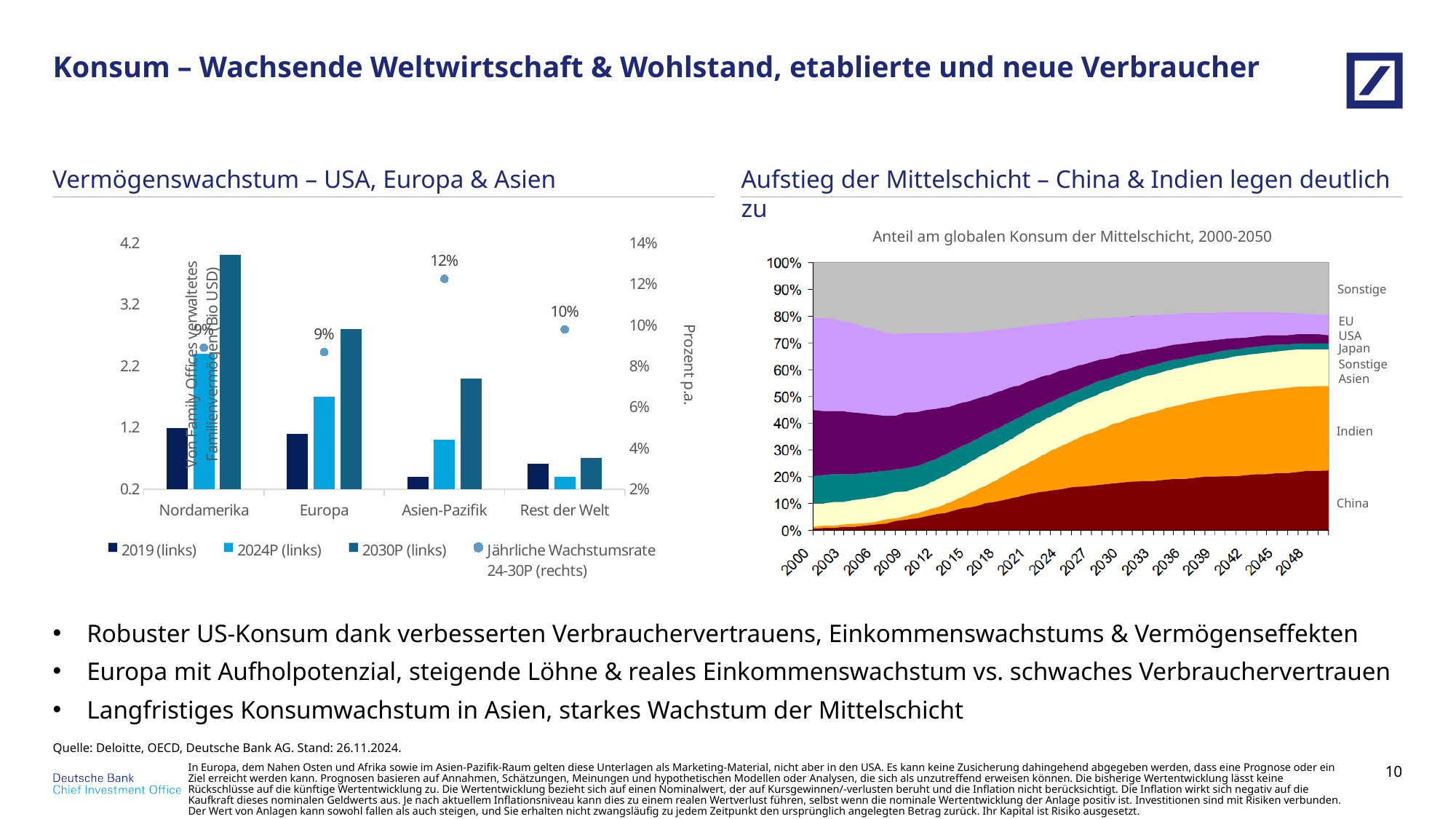
In the right chart (Anteil am globalen Konsum der Mittelschicht), does China's share rise or fall from 2000 to 2050? Rises In the left chart (Vermögenswachstum), is the 2019 value for Asien-Pazifik greater or less than 1.2? less In the left chart (Vermögenswachstum), which has the larger 2030P value: Europa or Asien-Pazifik? Europa In the left chart (Vermögenswachstum), is the 2030P value for Nordamerika greater or less than 3.2? greater How many entries does the legend of the left chart (Vermögenswachstum) list? 4 In the left chart (Vermögenswachstum), which region has the highest annual growth rate 24-30P? Asien-Pazifik How many regions are shown on the x axis of the left chart (Vermögenswachstum)? 4 What kind of chart is the right chart (Anteil am globalen Konsum der Mittelschicht, 2000-2050)? Stacked area chart In the left chart (Vermögenswachstum), what is the difference between the annual growth rates of Asien-Pazifik and Europa? 3 percentage points In the left chart (Vermögenswachstum), what is the annual growth rate shown for Rest der Welt? 10% In the left chart (Vermögenswachstum), what is the annual growth rate (Jährliche Wachstumsrate 24-30P) shown for Asien-Pazifik? 12% In the left chart (Vermögenswachstum), what is the annual growth rate shown for Europa? 9%